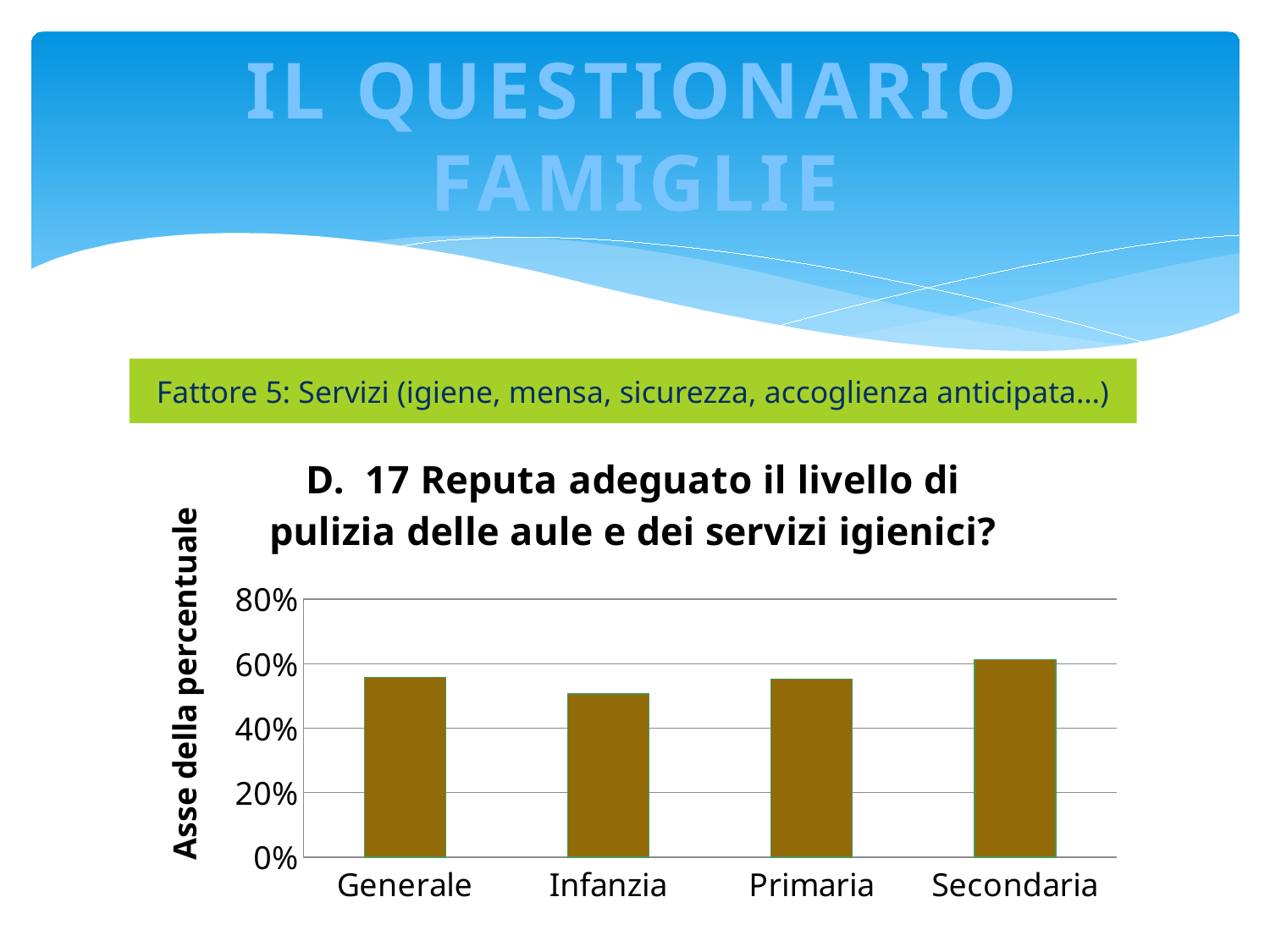
Is the value for Generale greater or less than 60%? less What is the title of the chart? D. 17 Reputa adeguato il livello di pulizia delle aule e dei servizi igienici? Is the value for Infanzia greater or less than 60%? less Is the value for Infanzia greater or less than 40%? greater What kind of chart is shown on the slide? bar chart What is the label of the vertical axis of the chart? Asse della percentuale Which category has the lowest value in the chart? Infanzia Which is larger, the value for Secondaria or the value for Infanzia? Secondaria How many categories are shown on the x axis of the chart? 4 Which category has the highest value in the chart? Secondaria